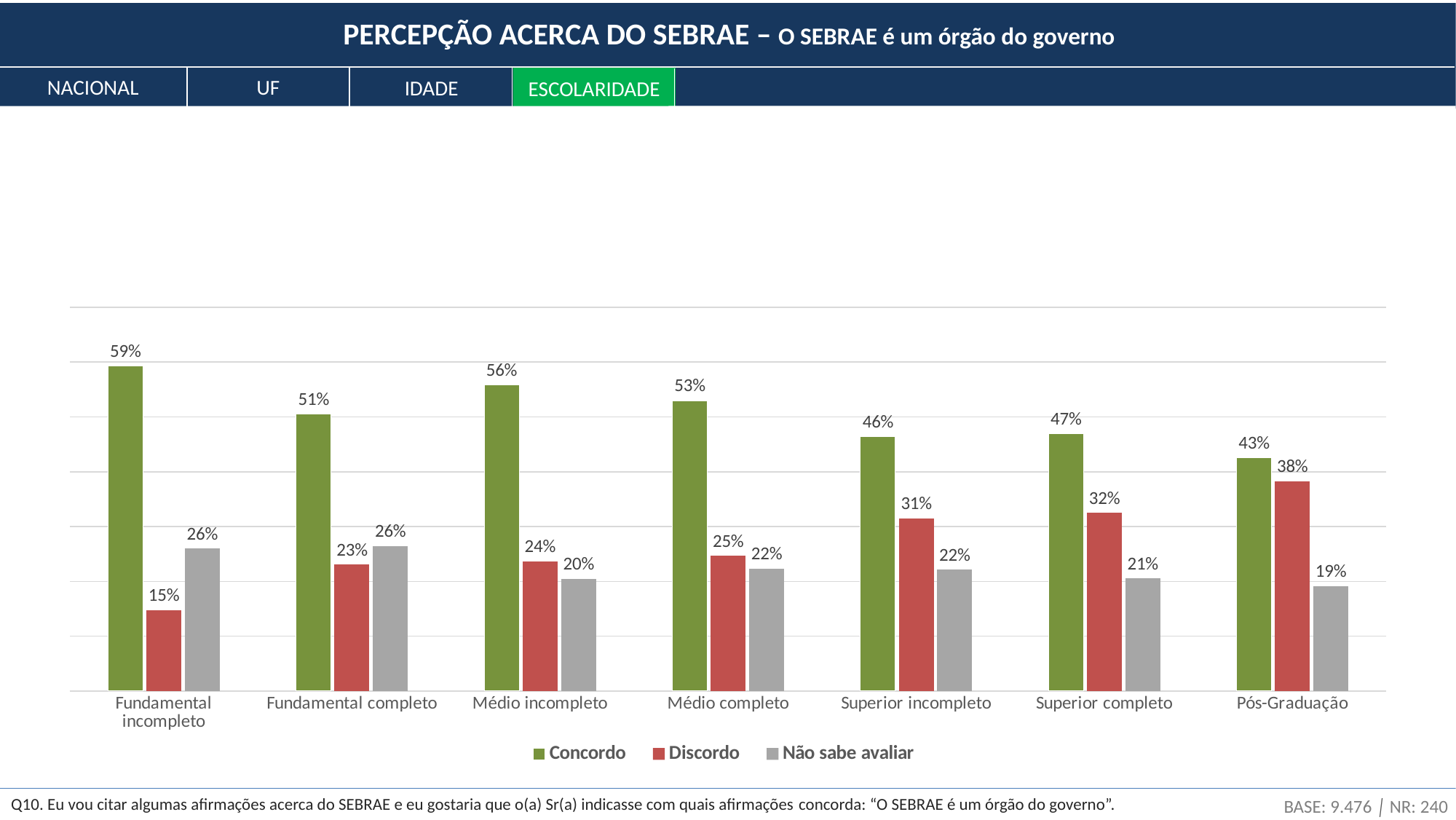
How many series does the legend list? 3 Which category has the lowest Discordo value? Fundamental incompleto What kind of chart is shown on the slide? Bar chart What is the Discordo value for Pós-Graduação? 38% Which tab is highlighted in green on the slide? ESCOLARIDADE Does the Discordo value generally rise or fall from Fundamental incompleto to Pós-Graduação? Rise Which category has the highest Concordo value? Fundamental incompleto What is the Não sabe avaliar value for Superior completo? 21% Which is larger for Superior incompleto: Discordo or Não sabe avaliar? Discordo What is the Concordo value for Fundamental incompleto? 59% What is the difference between the Concordo and Discordo values for Médio completo? 28 percentage points How many education categories are shown on the x axis? 7